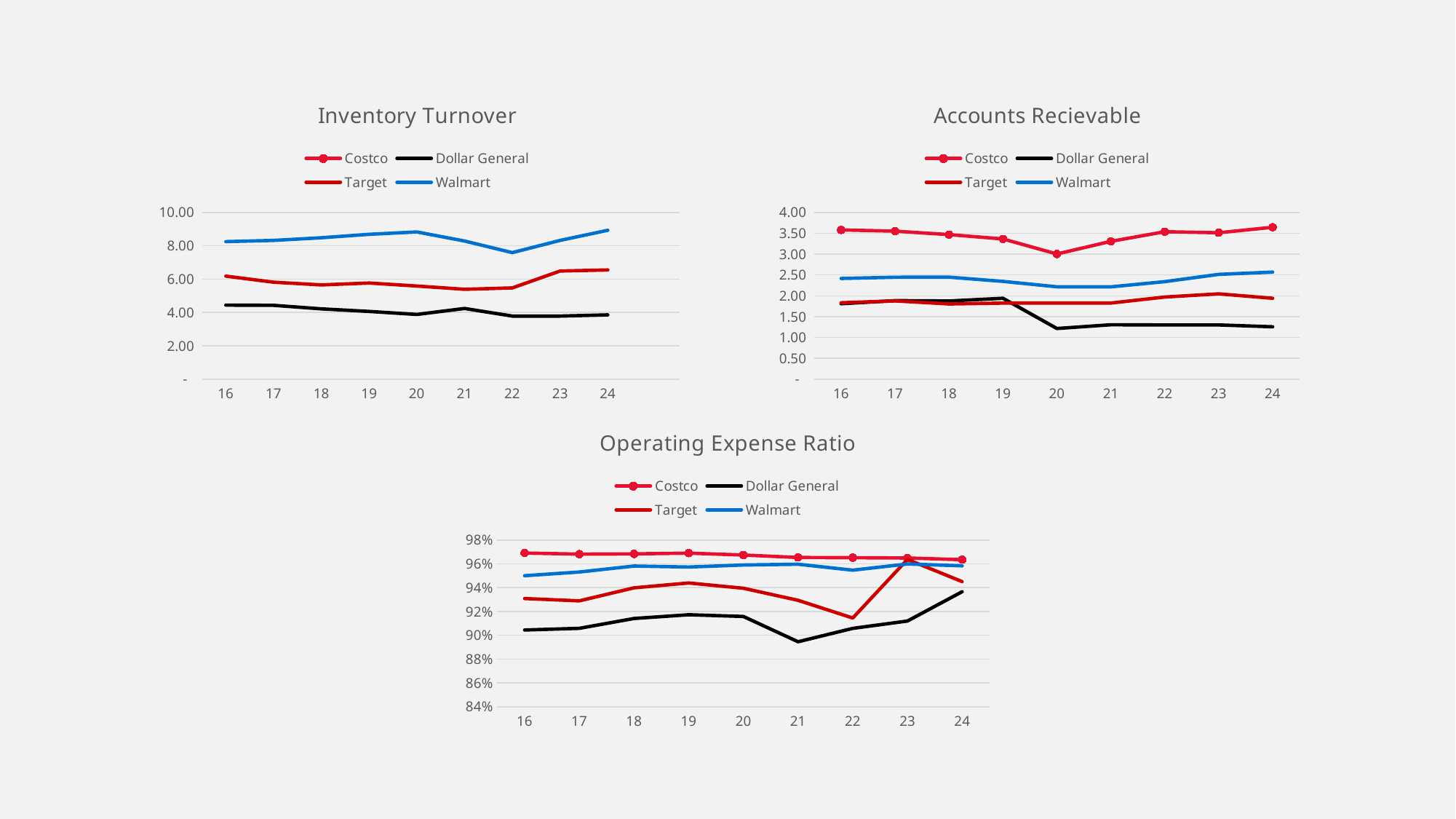
How many years are shown on the x axis of the Operating Expense Ratio chart? 9 In the Accounts Recievable chart, is the value for Dollar General in 20 greater or less than 1.50? less In the Operating Expense Ratio chart, which is larger in 21, Walmart or Target? Walmart In the Operating Expense Ratio chart, is the value for Dollar General in 21 greater or less than 90%? less In the Inventory Turnover chart, is the value for Target in 24 greater or less than 6.00? greater In the Operating Expense Ratio chart, which series has the highest value in 16? Costco How many series does the legend of the Accounts Recievable chart list? 4 In the Accounts Recievable chart, which series has the lowest value in 24? Dollar General What type of chart is the Inventory Turnover chart? line chart In the Accounts Recievable chart, does the Dollar General line rise or fall from 16 to 24? fall